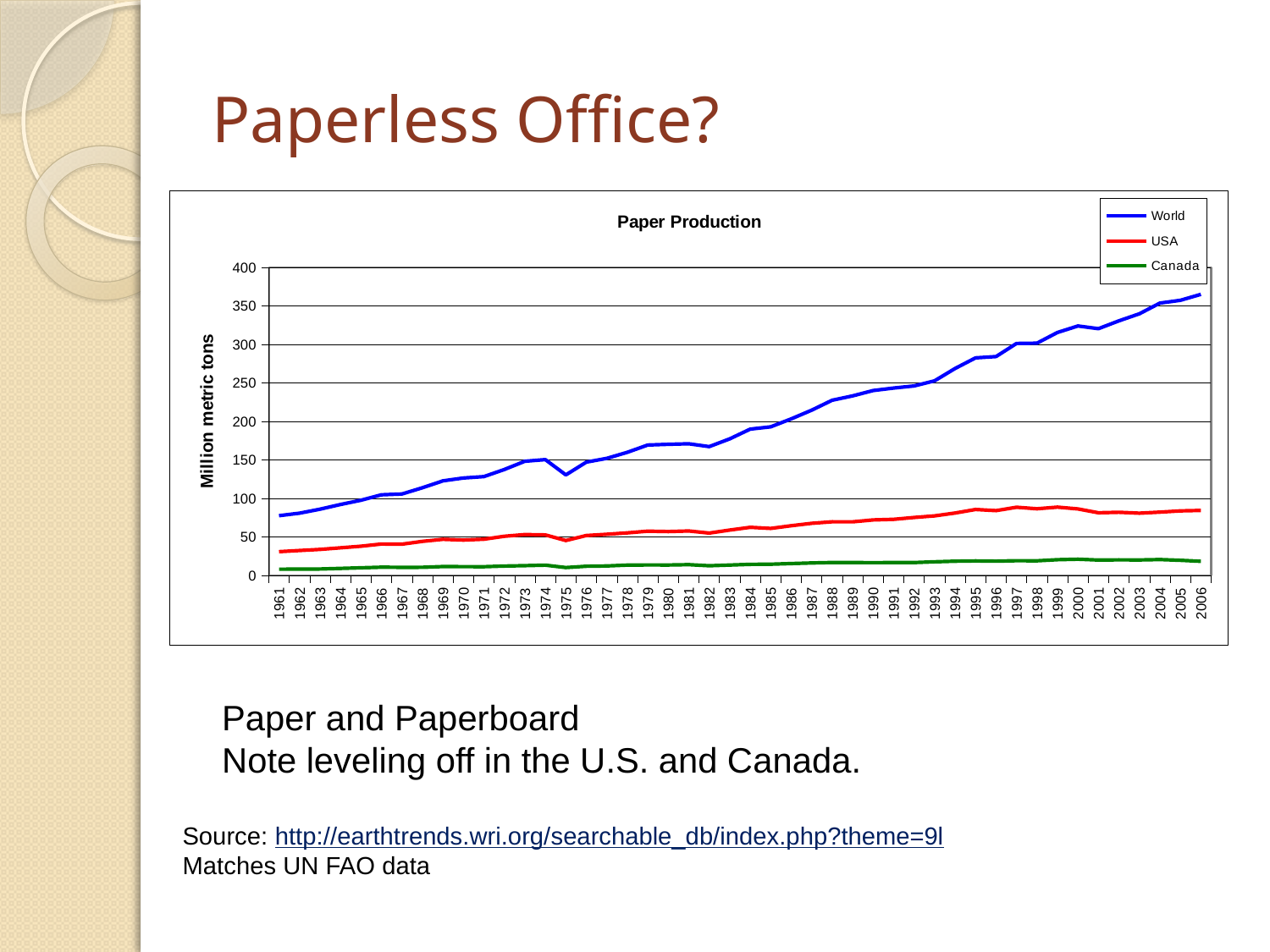
Is the value for World in 2006 greater or less than 350? greater What kind of chart is shown on the slide? line chart What is the label on the vertical axis of the chart? Million metric tons Which series has the highest value in 2006? World How many years are plotted along the x axis of the chart? 46 Which series has the lowest values throughout the chart? Canada Does the World series rise or fall from 1961 to 2006? rise What is the title of the chart? Paper Production Is the value for World in 1961 greater or less than 100? less Is the value for USA in 2006 greater or less than 100? less How many series does the legend of the Paper Production chart list? 3